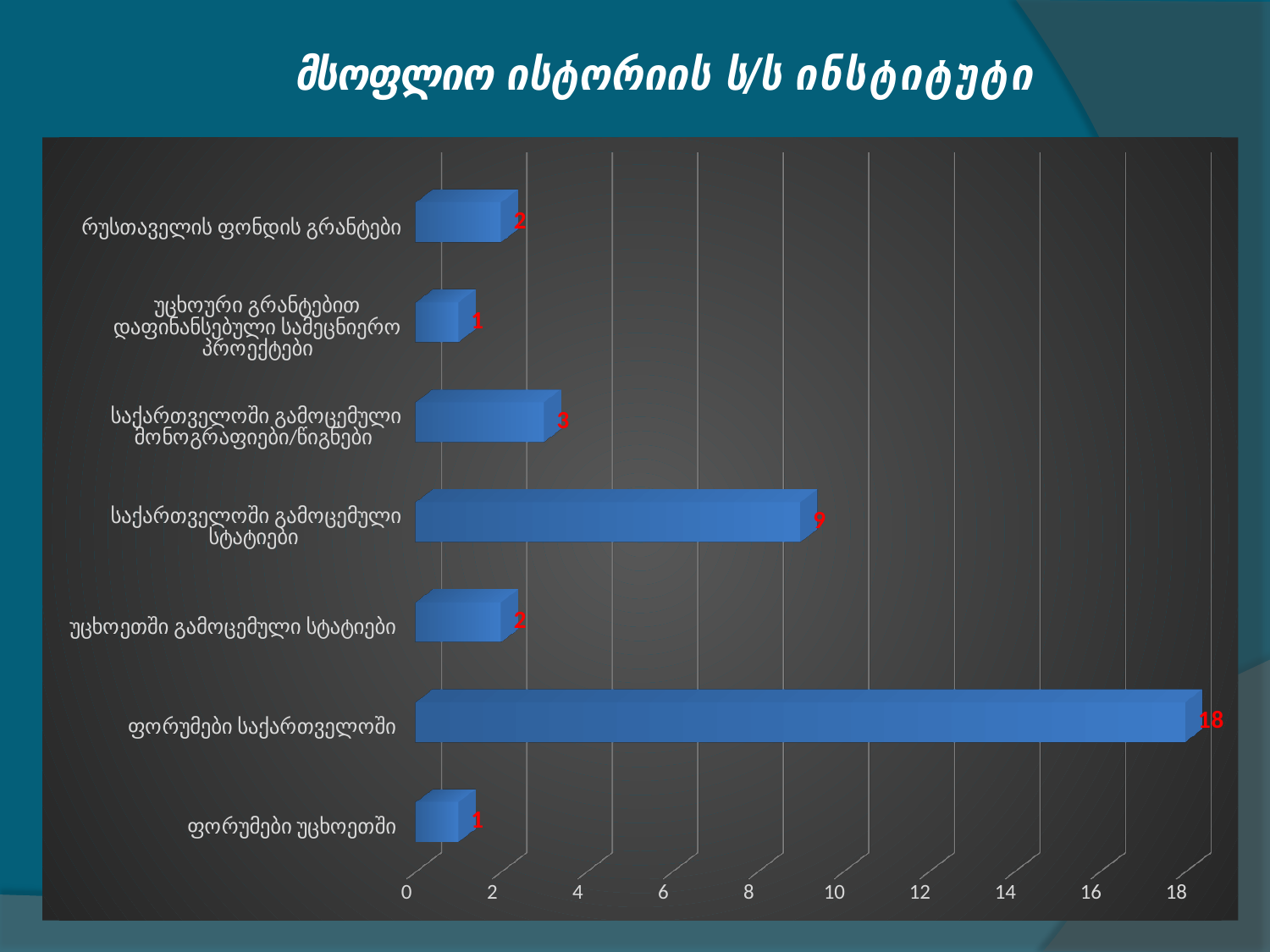
Which is larger: საქართველოში გამოცემული მონოგრაფიები/წიგნები or უცხოური გრანტებით დაფინანსებული სამეცნიერო პროექტები? საქართველოში გამოცემული მონოგრაფიები/წიგნები What is the value for საქართველოში გამოცემული სტატიები? 9 What is the difference between საქართველოში გამოცემული სტატიები and უცხოეთში გამოცემული სტატიები? 7 Which category has the highest value? ფორუმები საქართველოში What is the value for საქართველოში გამოცემული მონოგრაფიები/წიგნები? 3 What is the value for ფორუმები უცხოეთში? 1 What is the value for ფორუმები საქართველოში? 18 What kind of chart is shown on the slide? Bar chart How many categories are shown in the chart? 7 What is the difference between ფორუმები საქართველოში and ფორუმები უცხოეთში? 17 What is the value for რუსთაველის ფონდის გრანტები? 2 What is the title of the slide? მსოფლიო ისტორიის ს/ს ინსტიტუტი